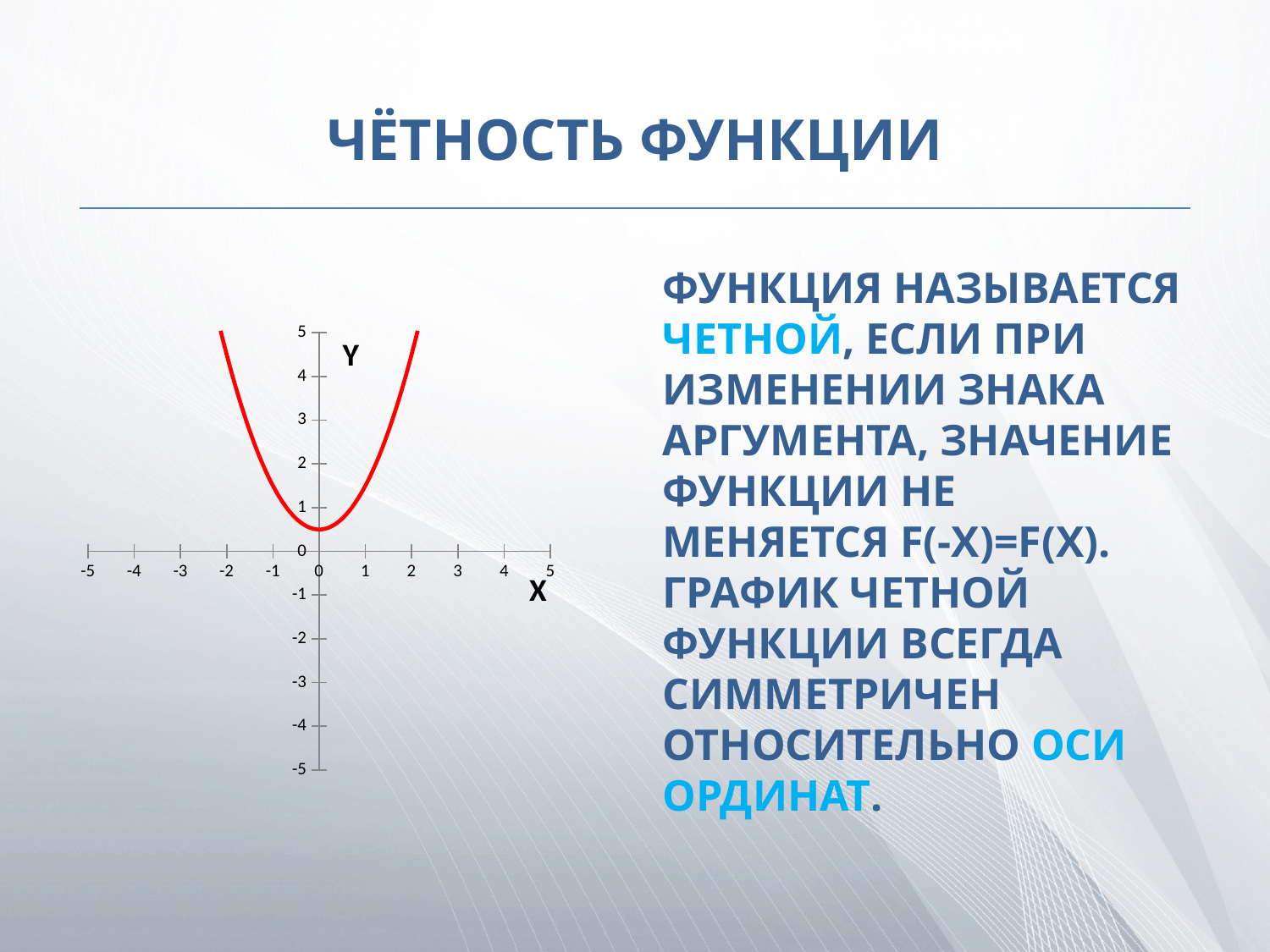
Is the value of the curve at x = 1 greater or less than 1? greater At which x value does the curve reach its lowest point? 0 What is the lowest value shown on the vertical axis? -5 Is the value of the curve at x = -1 greater or less than 3? less What colour is the plotted curve? red Does the curve rise or fall as x increases from -2 to 0? falls Does the curve rise or fall as x increases from 0 to 2? rises What is the highest value shown on the horizontal axis? 5 What is the label of the horizontal axis? X What kind of chart is shown on the slide? line chart Is the value of the curve at x = 0 greater or less than 1? less